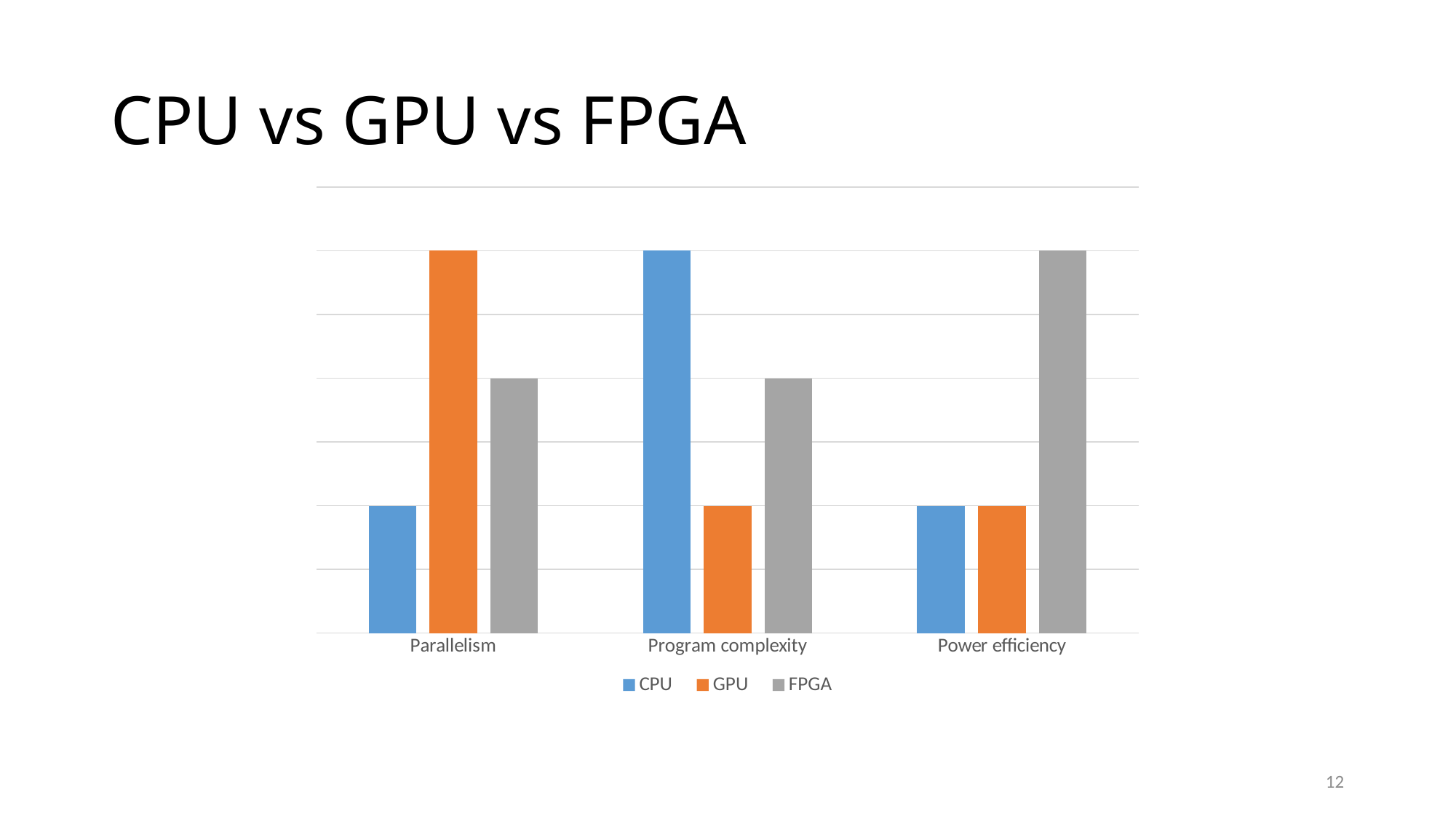
For Program complexity, which is larger: the FPGA bar or the CPU bar? CPU How many series does the chart's legend list? 3 Which series has the lowest bar in the Program complexity category? GPU For Parallelism, which is larger: the CPU bar or the GPU bar? GPU Which series has the lowest bar in the Parallelism category? CPU Which series has the highest bar in the Program complexity category? CPU Which series has the highest bar in the Parallelism category? GPU What colour represents the FPGA series in the chart? Grey Which series has the highest bar in the Power efficiency category? FPGA How many categories are shown on the x axis of the chart? 3 What kind of chart is shown on the slide? Bar chart